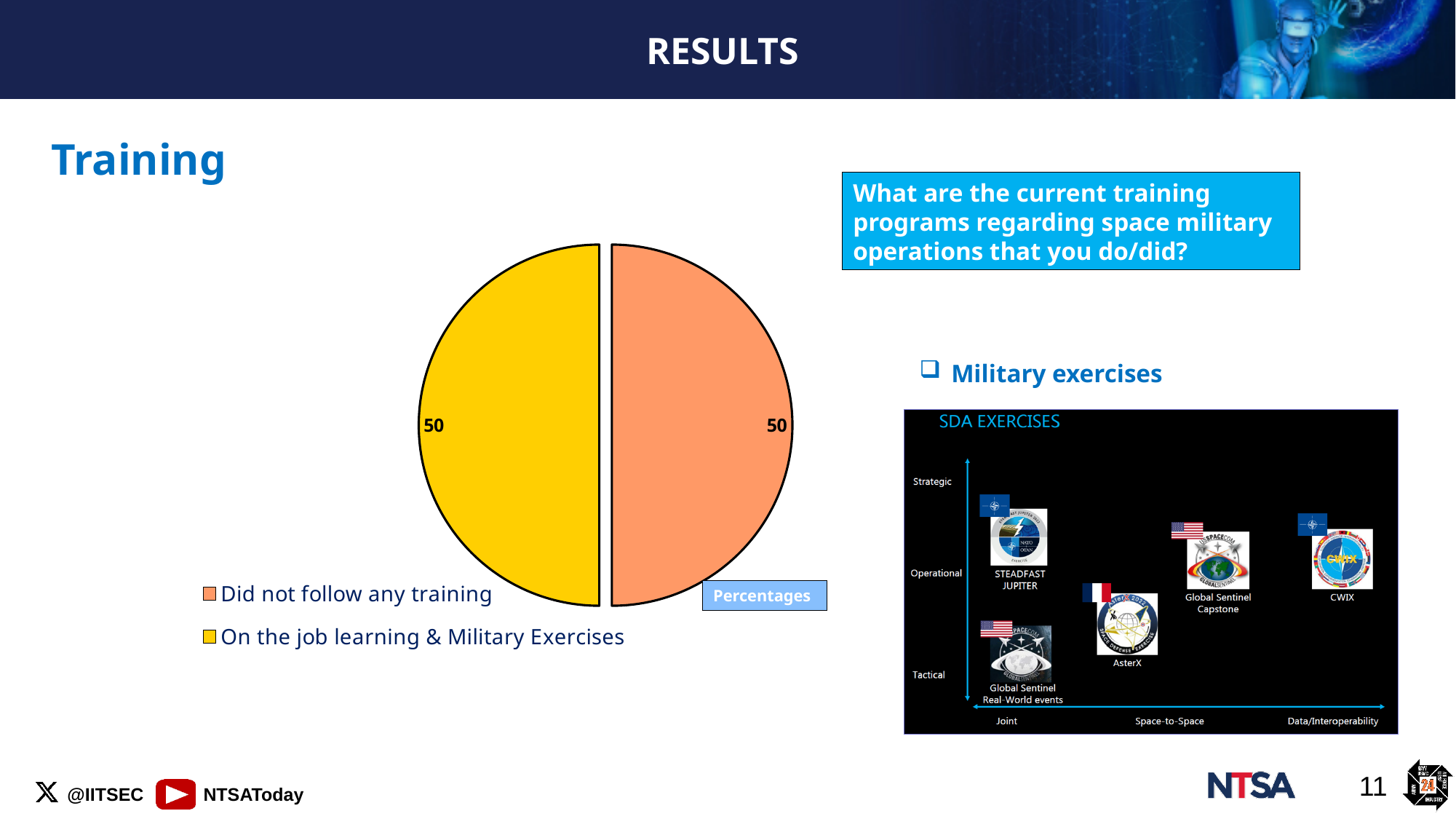
Which colour represents "On the job learning & Military Exercises" in the pie chart? Yellow What value is shown for the "On the job learning & Military Exercises" slice of the pie chart? 50 How many slices does the pie chart have? 2 What share of the pie does the "Did not follow any training" slice represent? 50% What value is shown for the "Did not follow any training" slice of the pie chart? 50 What is the total of the two values shown in the pie chart? 100 What kind of chart is shown on the left of the slide? Pie chart Are the values for "Did not follow any training" and "On the job learning & Military Exercises" equal in the pie chart? Yes What is the difference between the values of the two slices in the pie chart? 0 What is the name of the data series shown in the label box next to the pie chart? Percentages